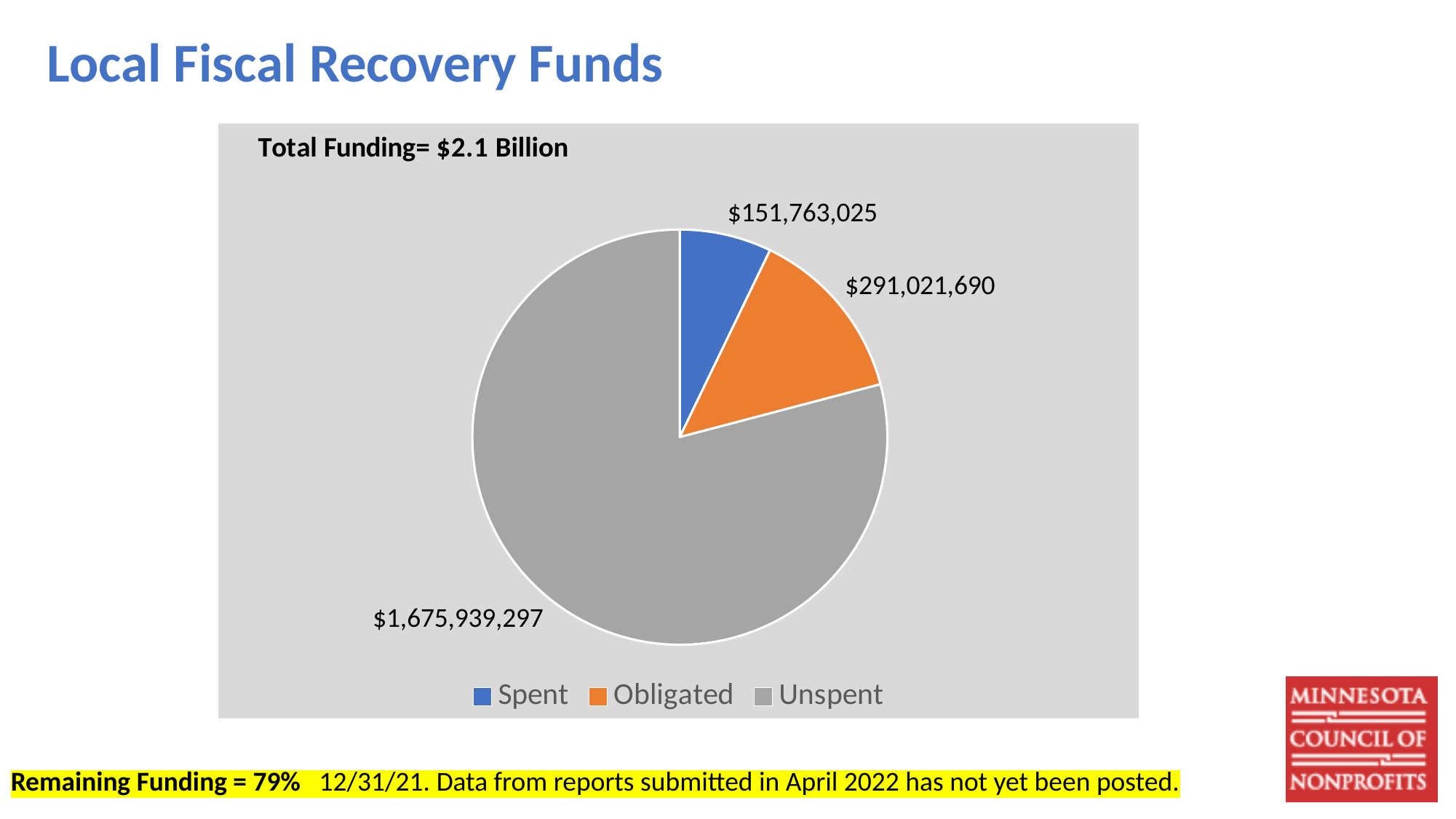
Which category has the largest slice of the pie? Unspent What is the value of the Obligated slice? $291,021,690 Which is larger, the Obligated slice or the Spent slice? Obligated What is the value of the Unspent slice? $1,675,939,297 What is the difference between the Unspent value and the Obligated value? $1,384,917,607 What is the title shown at the top of the chart? Total Funding= $2.1 Billion What kind of chart is shown on the slide? pie chart What is the value of the Spent slice? $151,763,025 What is the difference between the Obligated value and the Spent value? $139,258,665 Which category has the smallest slice of the pie? Spent What share of the total funding is Unspent, according to the slide? 79% How many slices does the pie chart have? 3